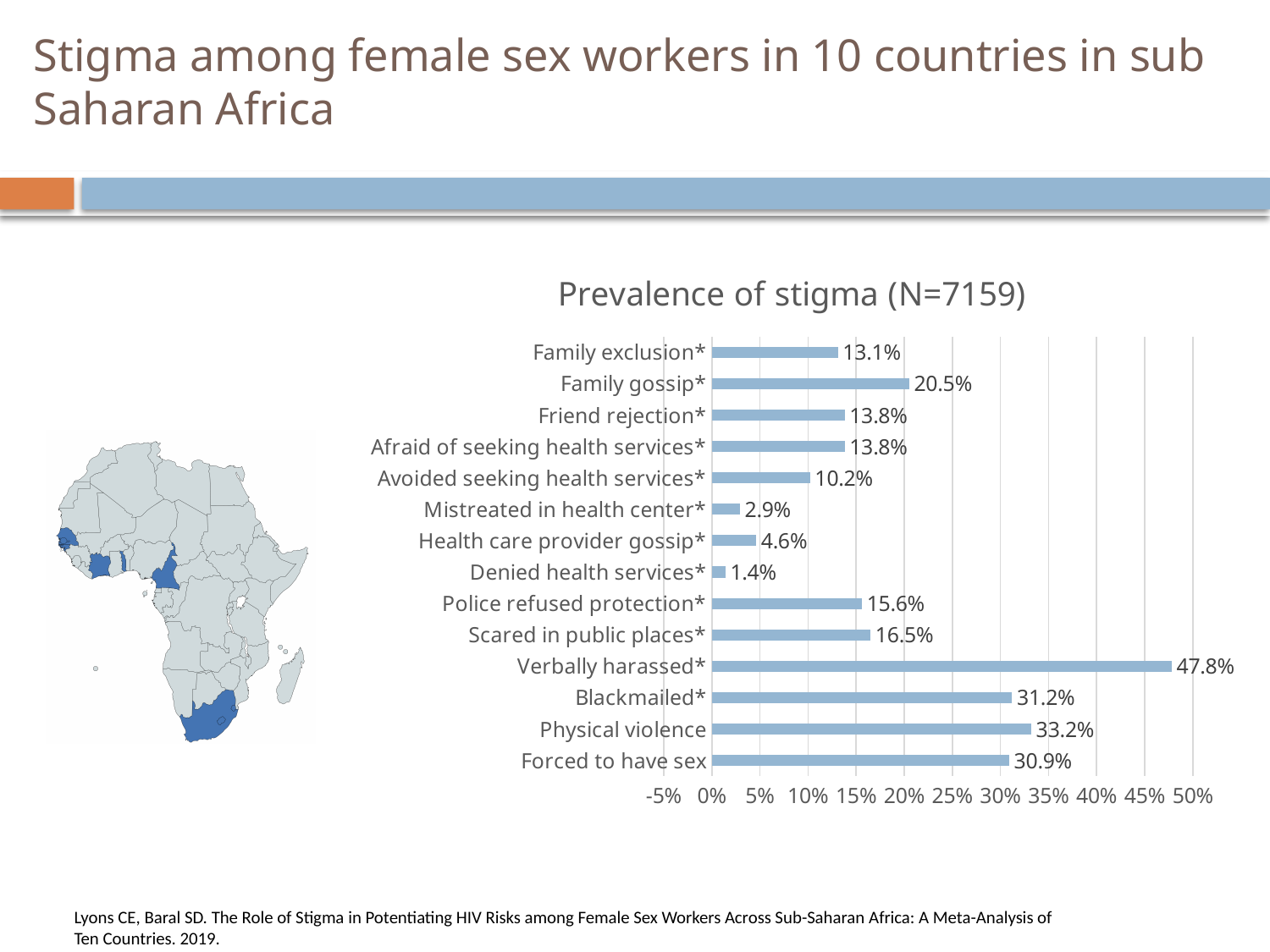
What kind of chart is shown? Bar chart What is the difference between Physical violence and Forced to have sex? 2.3% Which category has the lowest prevalence? Denied health services* What is the value for Family gossip*? 20.5% How many categories are shown in the chart? 14 Which is larger, Blackmailed* or Scared in public places*? Blackmailed* Which category has the highest prevalence? Verbally harassed* What is the value for Verbally harassed*? 47.8% What is the value for Physical violence? 33.2% What is the title of the chart? Prevalence of stigma (N=7159) What is the value for Denied health services*? 1.4% Is the value for Police refused protection* greater or less than 10%? greater